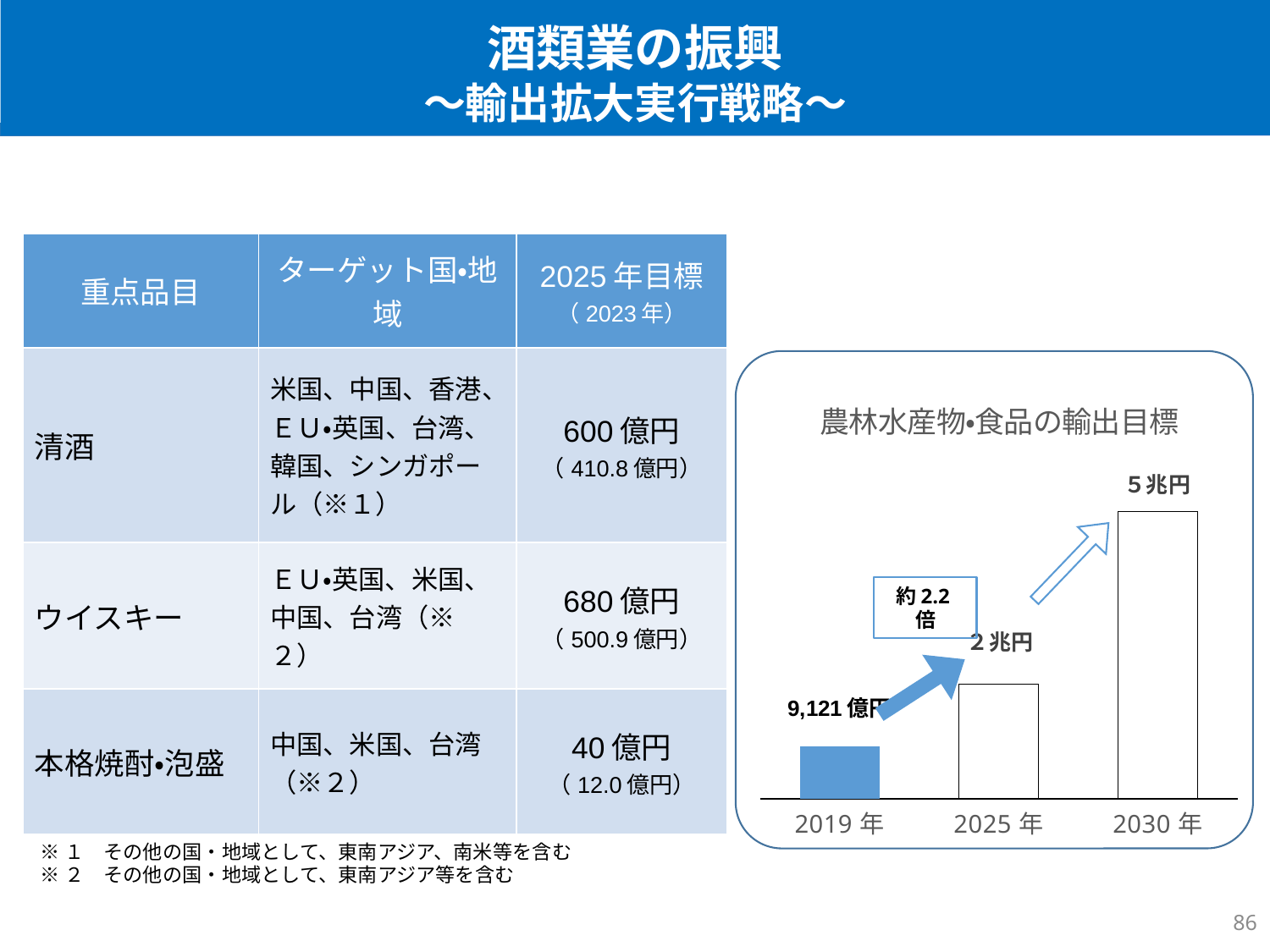
In the chart 農林水産物・食品の輸出目標, what is the difference between the values for 2030年 and 2025年? 3兆円 What is the title of the chart on the right side of the slide? 農林水産物・食品の輸出目標 In the chart 農林水産物・食品の輸出目標, what is the value for 2019年? 9,121億円 In the chart 農林水産物・食品の輸出目標, which is larger, the value for 2025年 or the value for 2030年? 2030年 How many bars are shown in the chart 農林水産物・食品の輸出目標? 3 In the chart 農林水産物・食品の輸出目標, what multiplier is shown in the box between the 2019年 and 2025年 bars? 約2.2倍 In the chart 農林水産物・食品の輸出目標, which year has the lowest value? 2019年 In the chart 農林水産物・食品の輸出目標, which year has the highest value? 2030年 In the chart 農林水産物・食品の輸出目標, what is the value for 2025年? 2兆円 In the chart 農林水産物・食品の輸出目標, what is the value for 2030年? 5兆円 In the chart 農林水産物・食品の輸出目標, do the values rise or fall from 2019年 to 2030年? rise What kind of chart is shown on the right side of the slide? bar chart